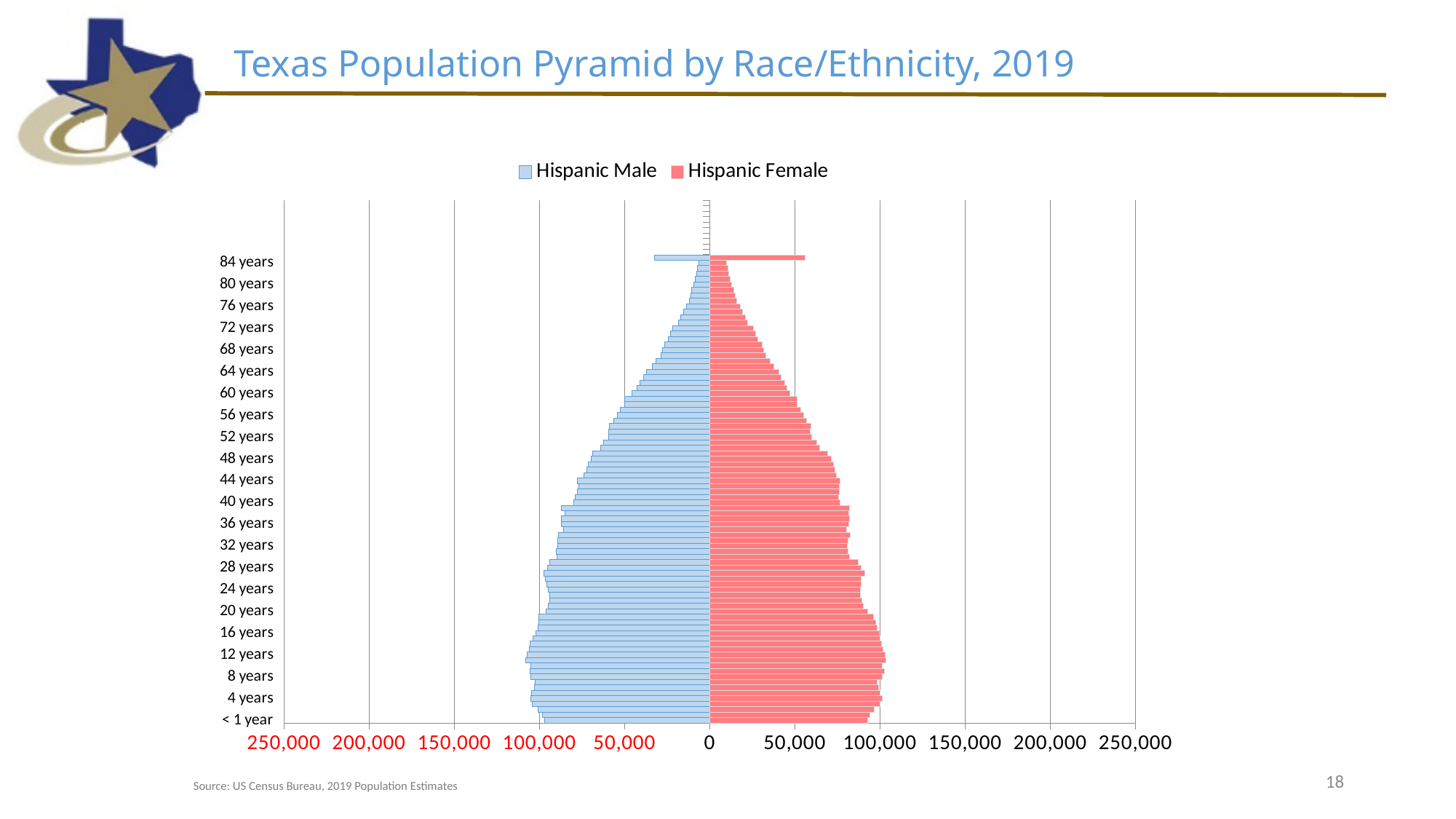
What are the two series named in the legend? Hispanic Male and Hispanic Female What is the title of the chart on the slide? Texas Population Pyramid by Race/Ethnicity, 2019 Do the Hispanic Female bars generally get longer or shorter as age increases from 20 years to 80 years? shorter At 84 years, which is larger: the Hispanic Male value or the Hispanic Female value? Hispanic Female Is the Hispanic Male value for 12 years greater or less than 100,000? greater Is the Hispanic Female value for 40 years greater or less than 100,000? less For Hispanic Male, which is larger: the value at 12 years or the value at 64 years? 12 years Is the Hispanic Male value for 64 years greater or less than 50,000? less How many series does the legend list? 2 What kind of chart is shown on the slide? Bar chart (population pyramid)